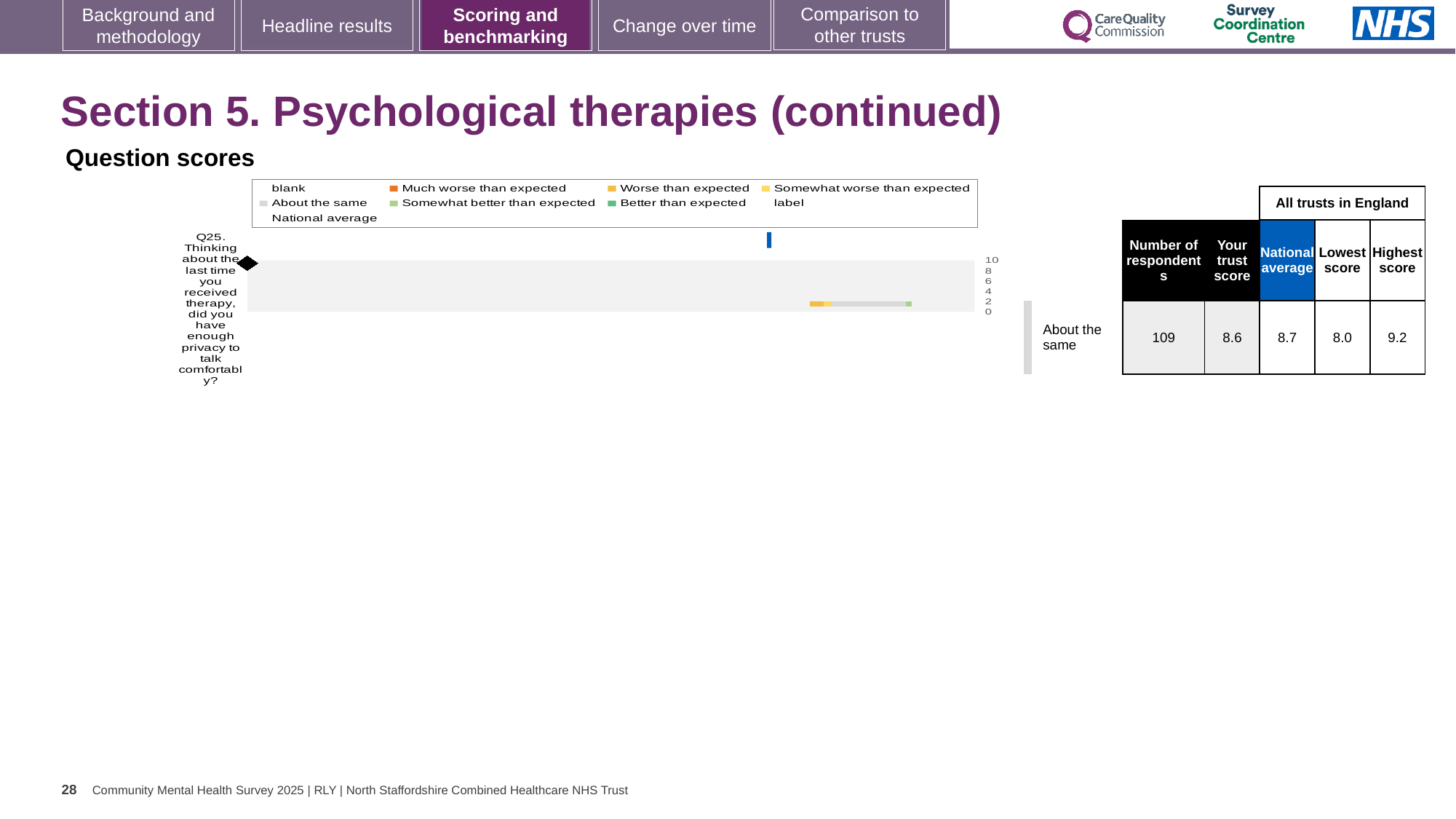
For Q25, which is larger: the trust's score or the national average? National average What is the trust's score for Q25 about having enough privacy to talk comfortably? 8.6 What is the highest score among all trusts in England for Q25? 9.2 What is the lowest score among all trusts in England for Q25? 8.0 What kind of chart is used to show the Q25 question score? bar chart What is the number of respondents for Q25 shown next to the chart? 109 What is the national average score for Q25? 8.7 What is the difference between the highest and lowest scores for Q25 across all trusts in England? 1.2 What is the maximum value shown on the chart's score axis? 10 What benchmarking category is shown for Q25 on the chart? About the same By how much does the national average exceed the trust's score for Q25? 0.1 How many survey questions are plotted on the question scores chart? 1